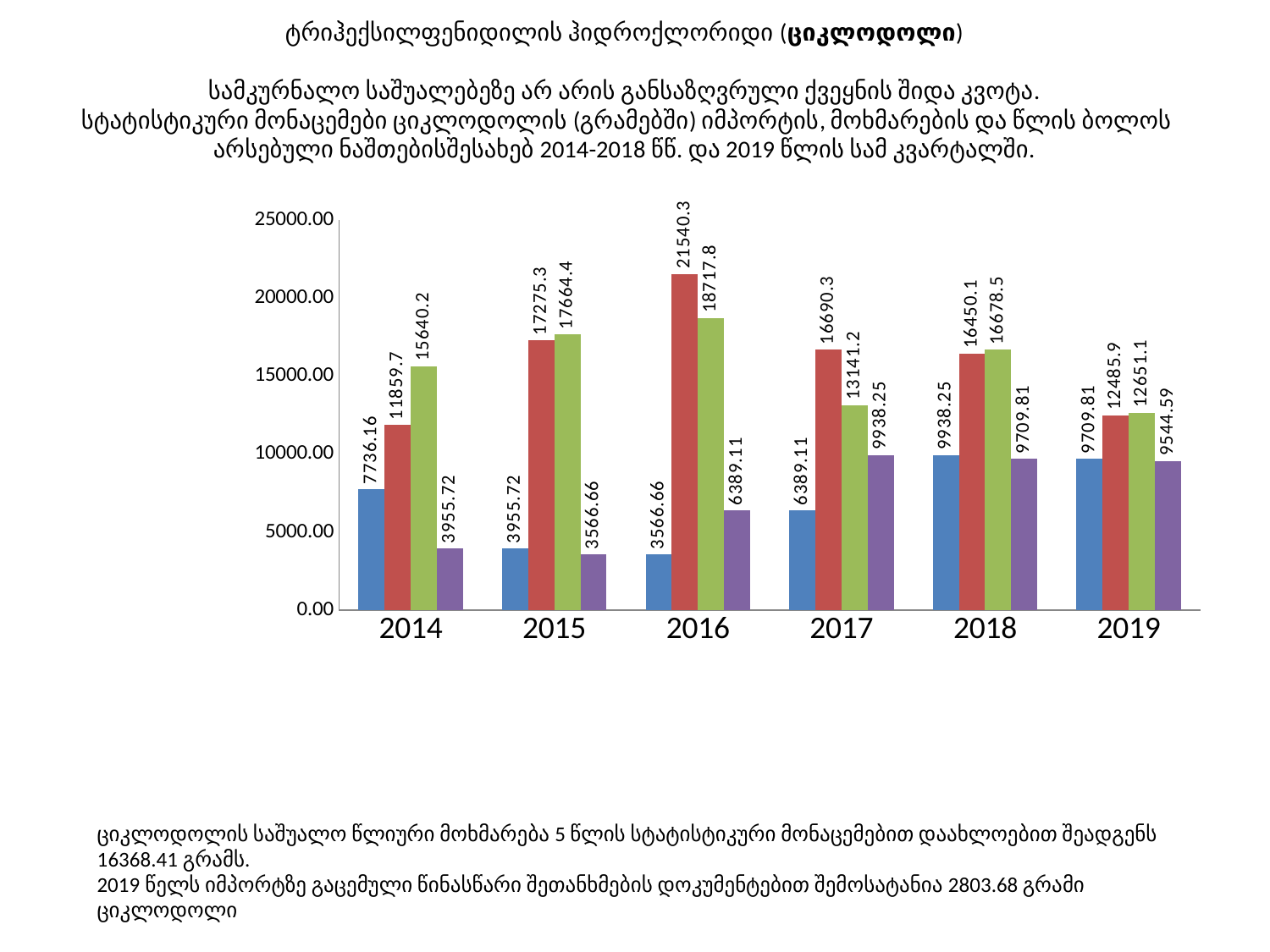
What is the difference between the red bar and the green bar in 2016? 2822.5 In which year is the purple bar the lowest? 2015 Which is larger in 2017, the red bar or the green bar? the red bar What is the value of the red bar for 2016? 21540.3 How many years (categories) are shown on the x axis of the chart? 6 What is the value of the blue bar for 2014? 7736.16 Does the blue bar rise or fall from 2016 to 2018? rise What type of chart is shown on the slide? bar chart What is the value of the purple bar for 2019? 9544.59 What is the value of the green bar for 2017? 13141.2 Is the value of the blue bar for 2018 greater or less than 5000? greater In which year is the red bar the highest? 2016